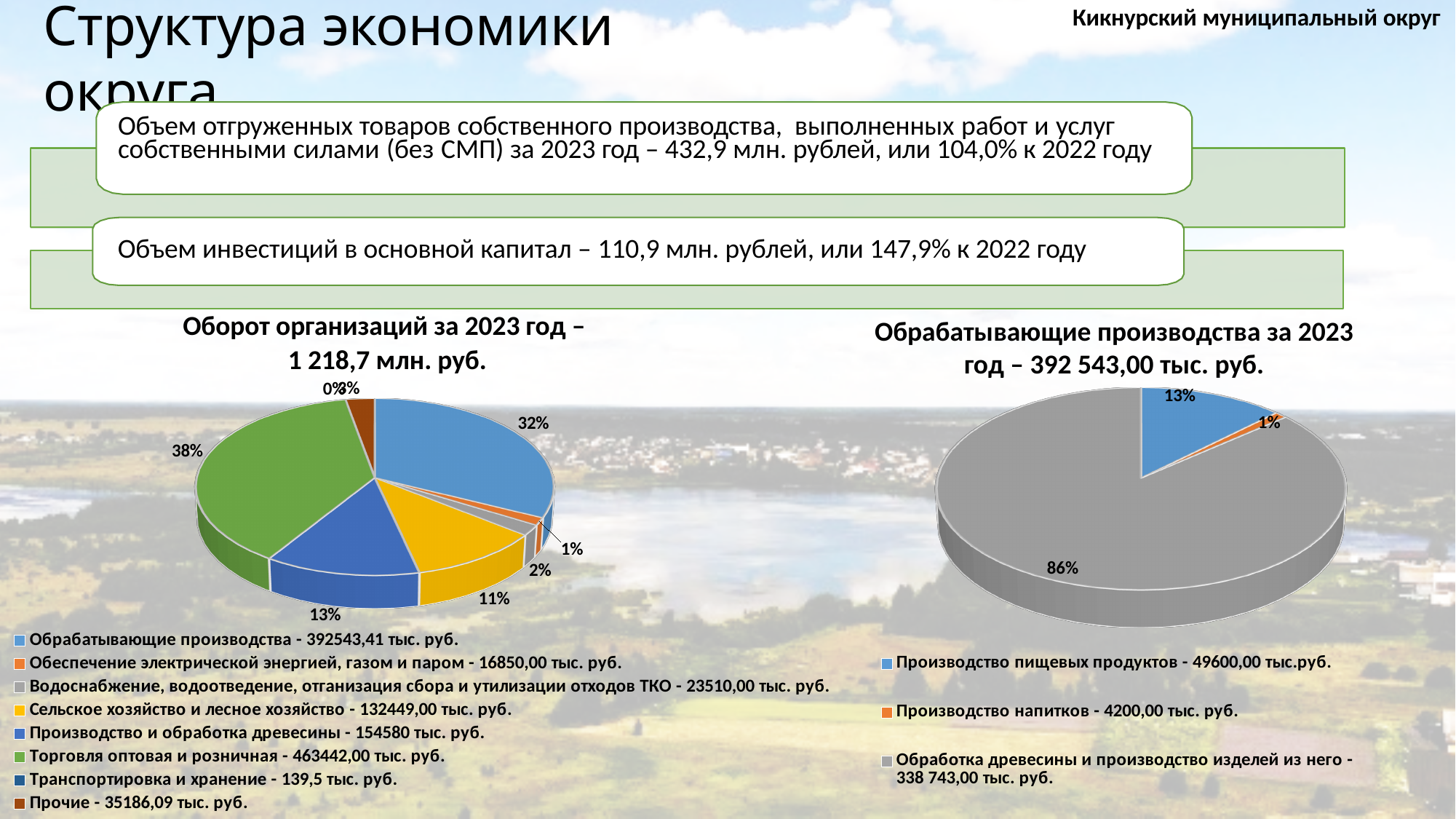
In the left chart "Оборот организаций за 2023 год", which category has the largest share? Торговля оптовая и розничная In the left chart "Оборот организаций за 2023 год", what value does the legend give for "Сельское хозяйство и лесное хозяйство"? 132449,00 тыс. руб. What kind of chart is the left chart titled "Оборот организаций за 2023 год"? pie chart In the left chart "Оборот организаций за 2023 год", which is larger: the share of "Производство и обработка древесины" or the share of "Сельское хозяйство и лесное хозяйство"? Производство и обработка древесины In the right chart "Обрабатывающие производства за 2023 год", which category has the smallest share? Производство напитков How many categories does the legend of the left chart "Оборот организаций за 2023 год" list? 8 In the left chart "Оборот организаций за 2023 год", what share does "Обрабатывающие производства" have? 32% In the right chart "Обрабатывающие производства за 2023 год", what share does "Обработка древесины и производство изделей из него" have? 86% In the left chart "Оборот организаций за 2023 год", what share does "Торговля оптовая и розничная" have? 38% In the right chart "Обрабатывающие производства за 2023 год", what value does the legend give for "Производство пищевых продуктов"? 49600,00 тыс.руб. How many categories does the legend of the right chart "Обрабатывающие производства за 2023 год" list? 3 In the left chart "Оборот организаций за 2023 год", what is the difference in percentage points between the share of "Торговля оптовая и розничная" and the share of "Обрабатывающие производства"? 6 percentage points